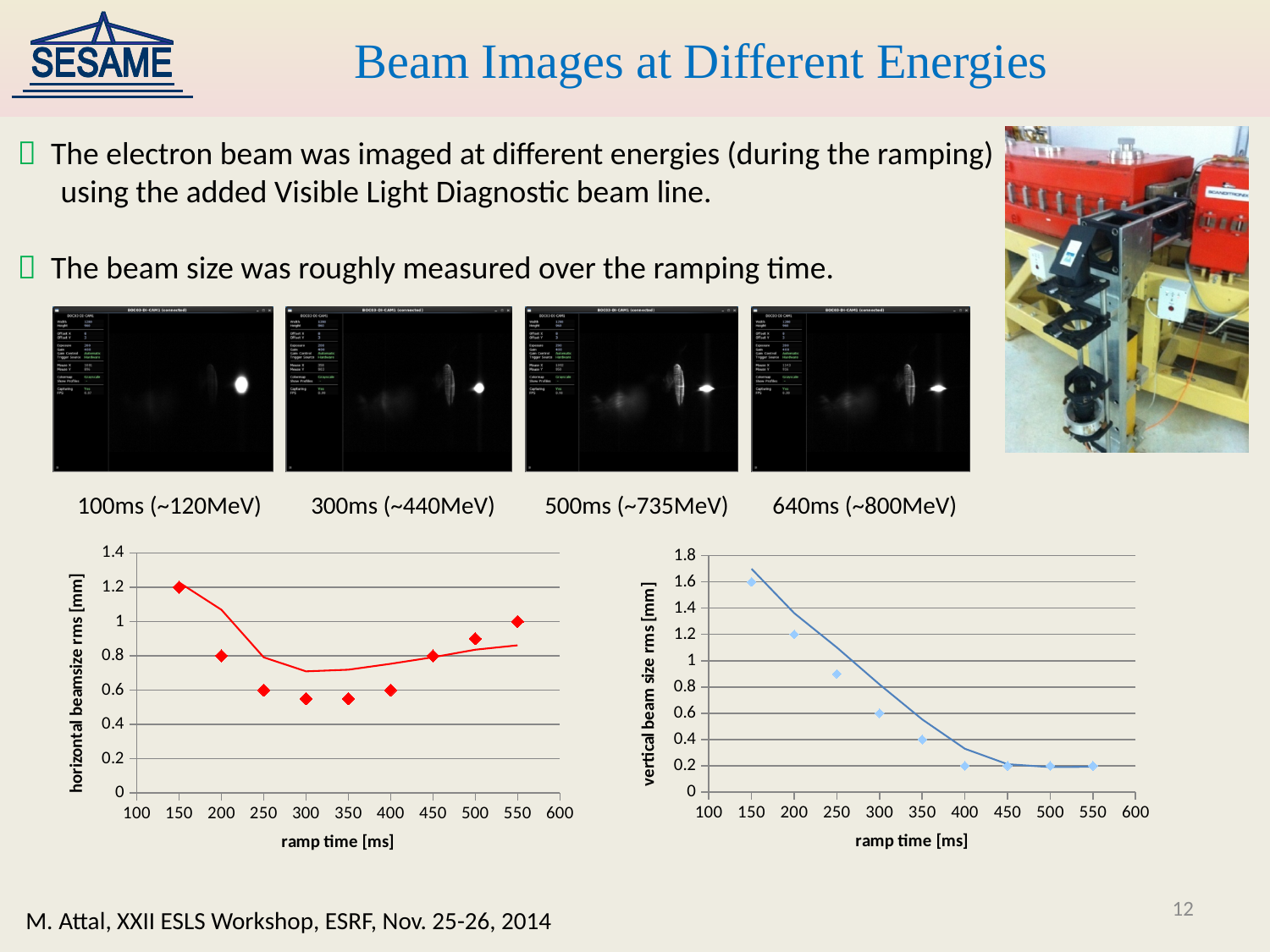
In the left chart (horizontal beamsize rms), at which ramp time is the horizontal beam size highest? 150 ms In the right chart (vertical beam size rms), at which ramp time is the vertical beam size highest? 150 ms In the right chart (vertical beam size rms), do the values rise or fall as ramp time increases from 150 ms to 400 ms? fall In the right chart (vertical beam size rms), is the vertical beam size at 500 ms greater or less than 0.4? less In the left chart (horizontal beamsize rms), is the horizontal beam size at 300 ms greater or less than 0.8? less In the right chart (vertical beam size rms), is the vertical beam size at 250 ms greater or less than 0.8? greater In the left chart (horizontal beamsize rms), what is the horizontal beam size at a ramp time of 150 ms? 1.2 In the right chart (vertical beam size rms), what is the vertical beam size at a ramp time of 150 ms? 1.6 What is the x-axis title of the left chart (horizontal beamsize rms)? ramp time [ms] In the right chart (vertical beam size rms), what is the vertical beam size at a ramp time of 200 ms? 1.2 In the left chart (horizontal beamsize rms), which is larger: the horizontal beam size at 150 ms or at 550 ms? 150 ms How many data points are plotted in the right chart (vertical beam size rms)? 9